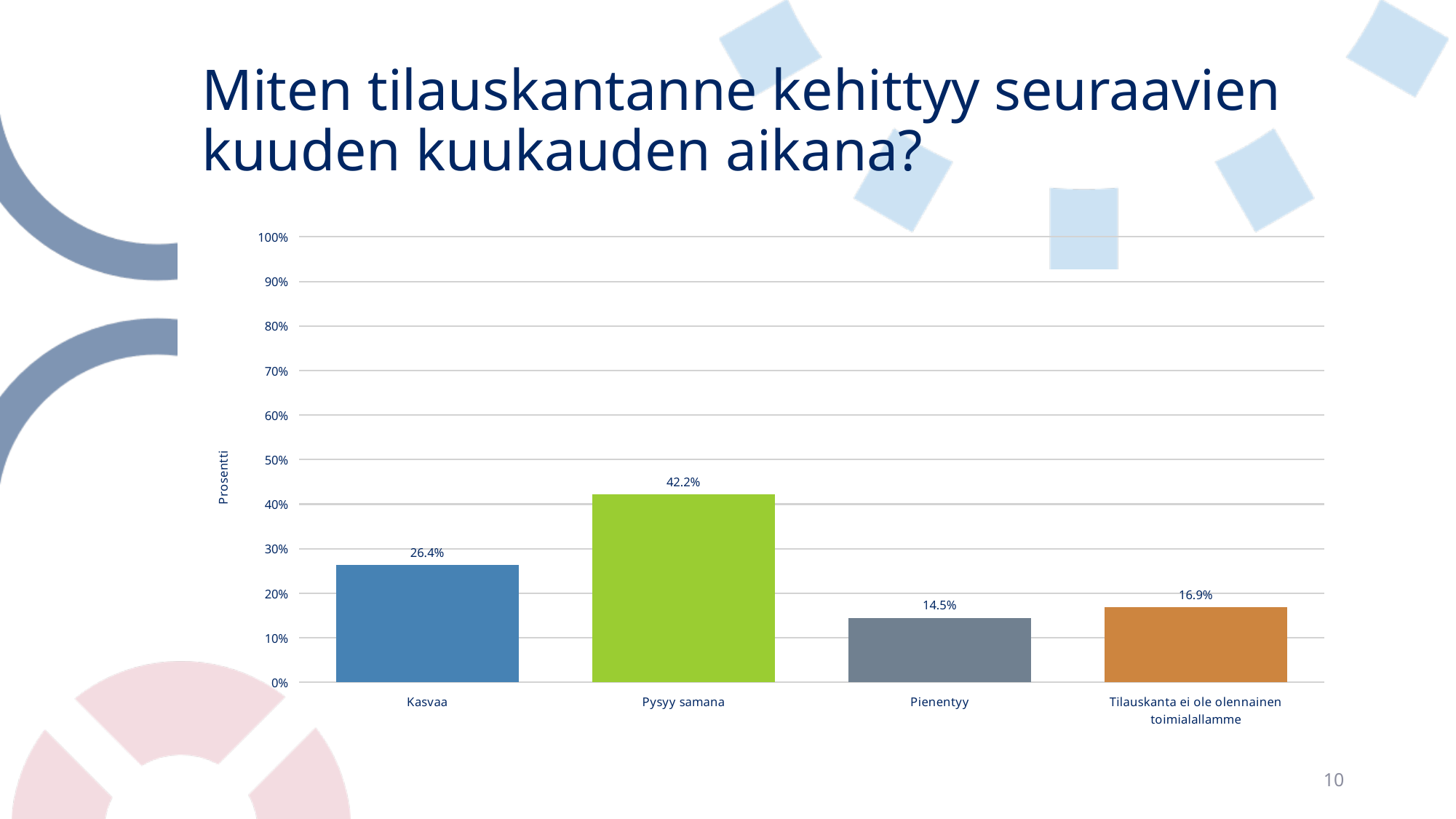
What is the value for Tilauskanta ei ole olennainen toimialallamme? 16.9% Which category has the highest value? Pysyy samana How many categories are shown on the x axis? 4 Which category has the lowest value? Pienentyy What is the label of the y axis? Prosentti Which is larger, the value for Kasvaa or the value for Tilauskanta ei ole olennainen toimialallamme? Kasvaa What is the difference between the values for Pysyy samana and Kasvaa? 15.8% Is the value for Pysyy samana greater or less than 40%? greater What is the value for Kasvaa? 26.4% What is the value for Pysyy samana? 42.2% What is the value for Pienentyy? 14.5% What kind of chart is shown on the slide? bar chart